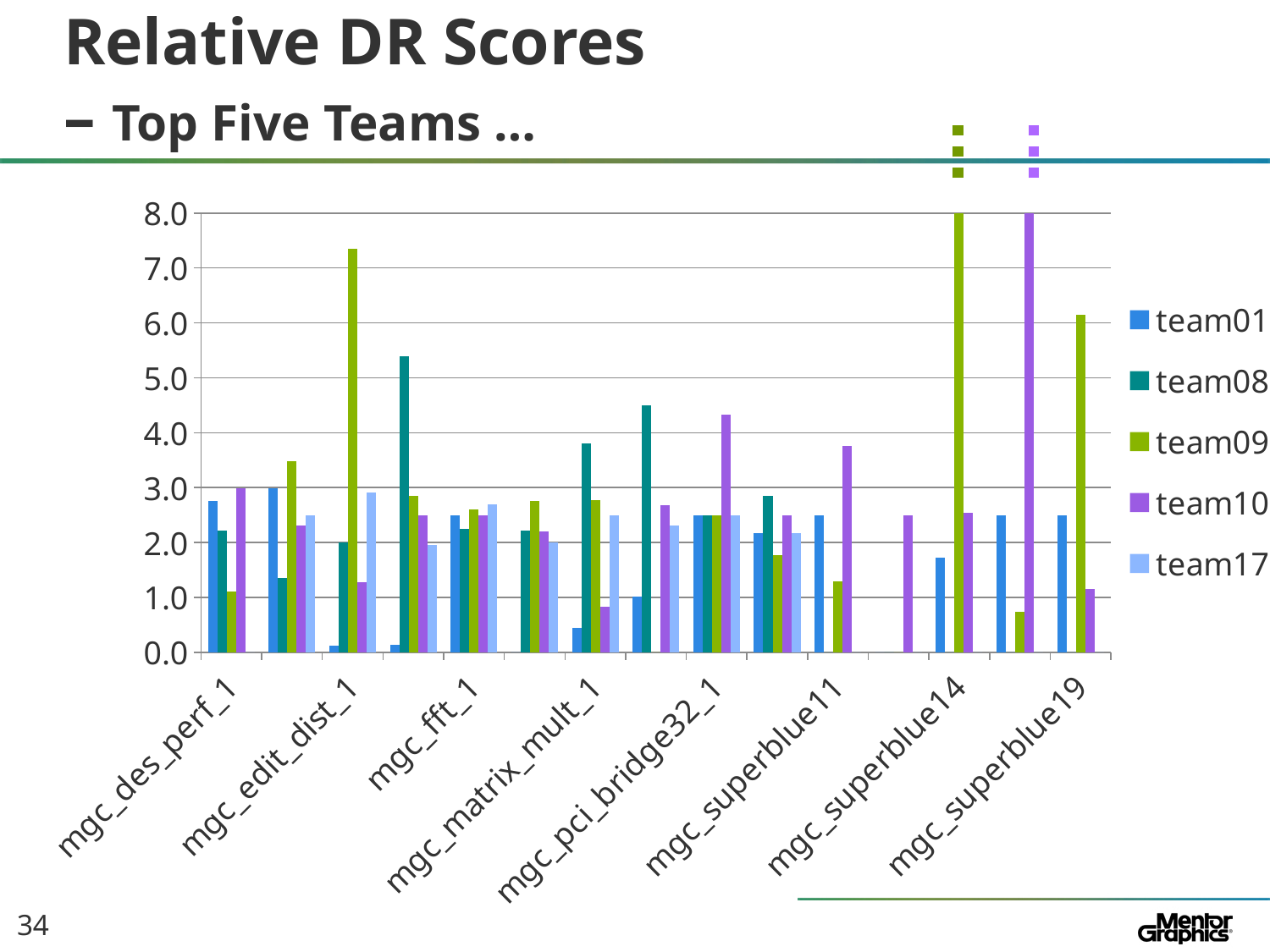
Which team has the highest value for mgc_matrix_mult_1? team08 Is the value for team09 at mgc_edit_dist_1 greater or less than 7.0? greater Is the value for team09 at mgc_superblue19 greater or less than 5.0? greater Is the value for team10 at mgc_superblue11 greater or less than 3.0? greater Which is larger at mgc_superblue19, the value for team09 or the value for team10? team09 How many series does the legend list? 5 What kind of chart is shown on the slide? bar chart Which team has the highest value for mgc_edit_dist_1? team09 Which team has the lowest value for mgc_edit_dist_1? team01 Which team has the highest value for mgc_pci_bridge32_1? team10 What is the maximum value shown on the vertical axis? 8.0